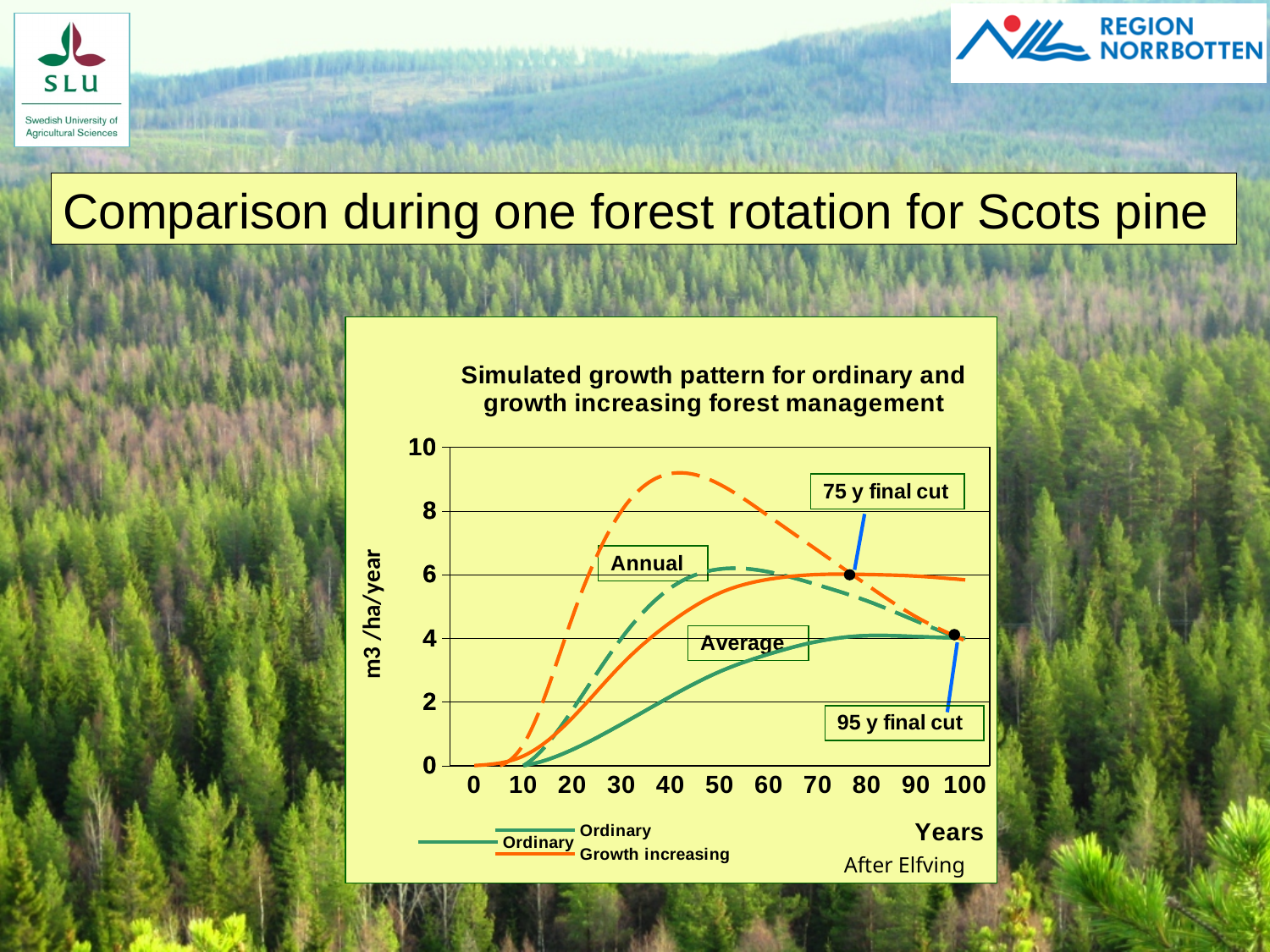
Is the value of the solid Ordinary (Average) curve at 100 years greater or less than 2 m3/ha/year? greater At what age is the final cut marked for the Growth increasing management? 75 y At what age is the final cut marked for the Ordinary management? 95 y What is the label of the vertical axis of the chart? m3 /ha/year What is the title of the chart? Simulated growth pattern for ordinary and growth increasing forest management What kind of chart is shown on the slide? Line chart Which management type reaches the higher peak annual growth, Ordinary or Growth increasing? Growth increasing Is the peak value of the dashed Growth increasing (Annual) curve greater or less than 8 m3/ha/year? greater Does the dashed Growth increasing (Annual) curve rise or fall between 40 and 100 years? Fall Is the value of the solid Ordinary (Average) curve at 50 years greater or less than 4 m3/ha/year? less How many management types does the chart legend list? 2